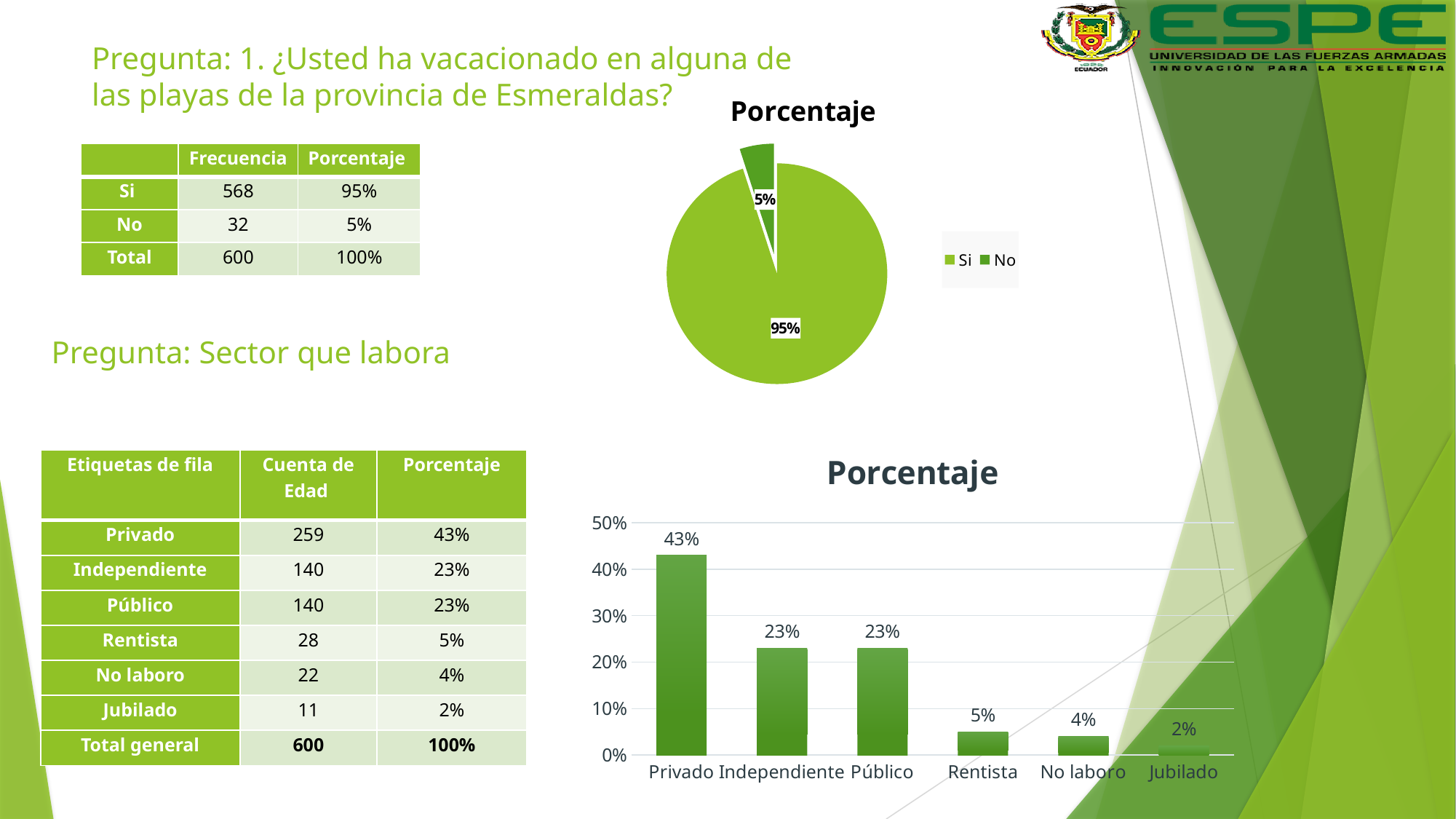
In the bar chart at the bottom of the slide, what is the difference between the values for Privado and Público? 20% How many categories are shown on the x axis of the bar chart at the bottom of the slide? 6 In the pie chart at the top of the slide, what share does the 'No' slice represent? 5% What kind of chart is the bottom chart on the slide? bar chart How many entries does the legend of the pie chart list? 2 In the bar chart at the bottom of the slide, which is larger, the value for Rentista or the value for No laboro? Rentista In the pie chart at the top of the slide, what share does the 'Si' slice represent? 95% In the bar chart at the bottom of the slide, which category has the lowest value? Jubilado In the bar chart at the bottom of the slide, which category has the highest value? Privado In the bar chart at the bottom of the slide, what is the value for Rentista? 5% In the bar chart at the bottom of the slide, what is the value for Privado? 43% What kind of chart is the top chart on the slide? pie chart